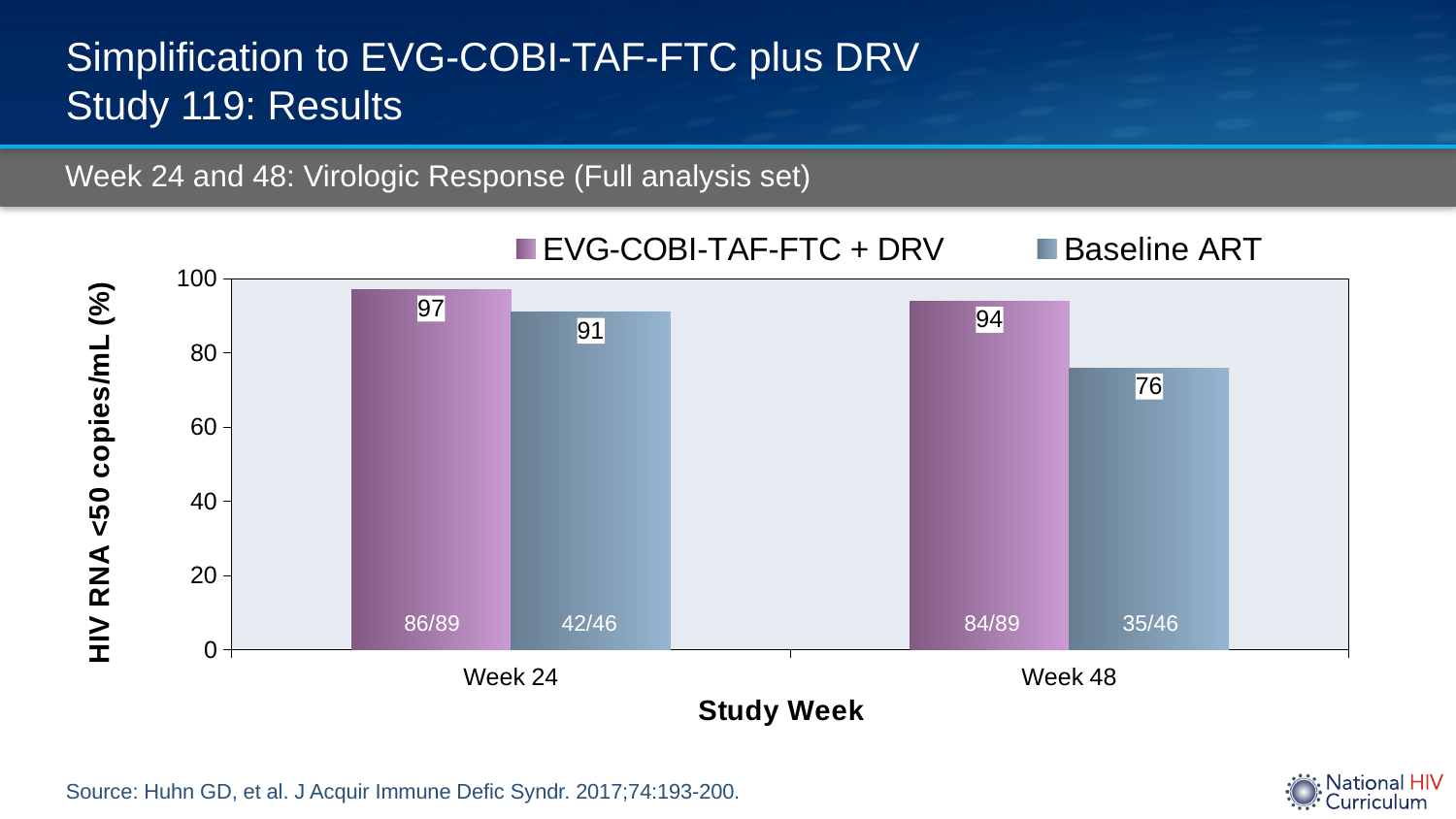
What is the difference between EVG-COBI-TAF-FTC + DRV and Baseline ART at Week 48? 18 What is the value for Baseline ART at Week 48? 76 What is the value for Baseline ART at Week 24? 91 Which is larger at Week 24: EVG-COBI-TAF-FTC + DRV or Baseline ART? EVG-COBI-TAF-FTC + DRV Which series has the lowest value at Week 48? Baseline ART How many study week categories are shown on the x axis? 2 What is the value for EVG-COBI-TAF-FTC + DRV at Week 48? 94 What is the label of the x axis? Study Week What is the value for EVG-COBI-TAF-FTC + DRV at Week 24? 97 What is the difference between EVG-COBI-TAF-FTC + DRV and Baseline ART at Week 24? 6 How many series does the legend list? 2 What kind of chart is shown on the slide? Bar chart